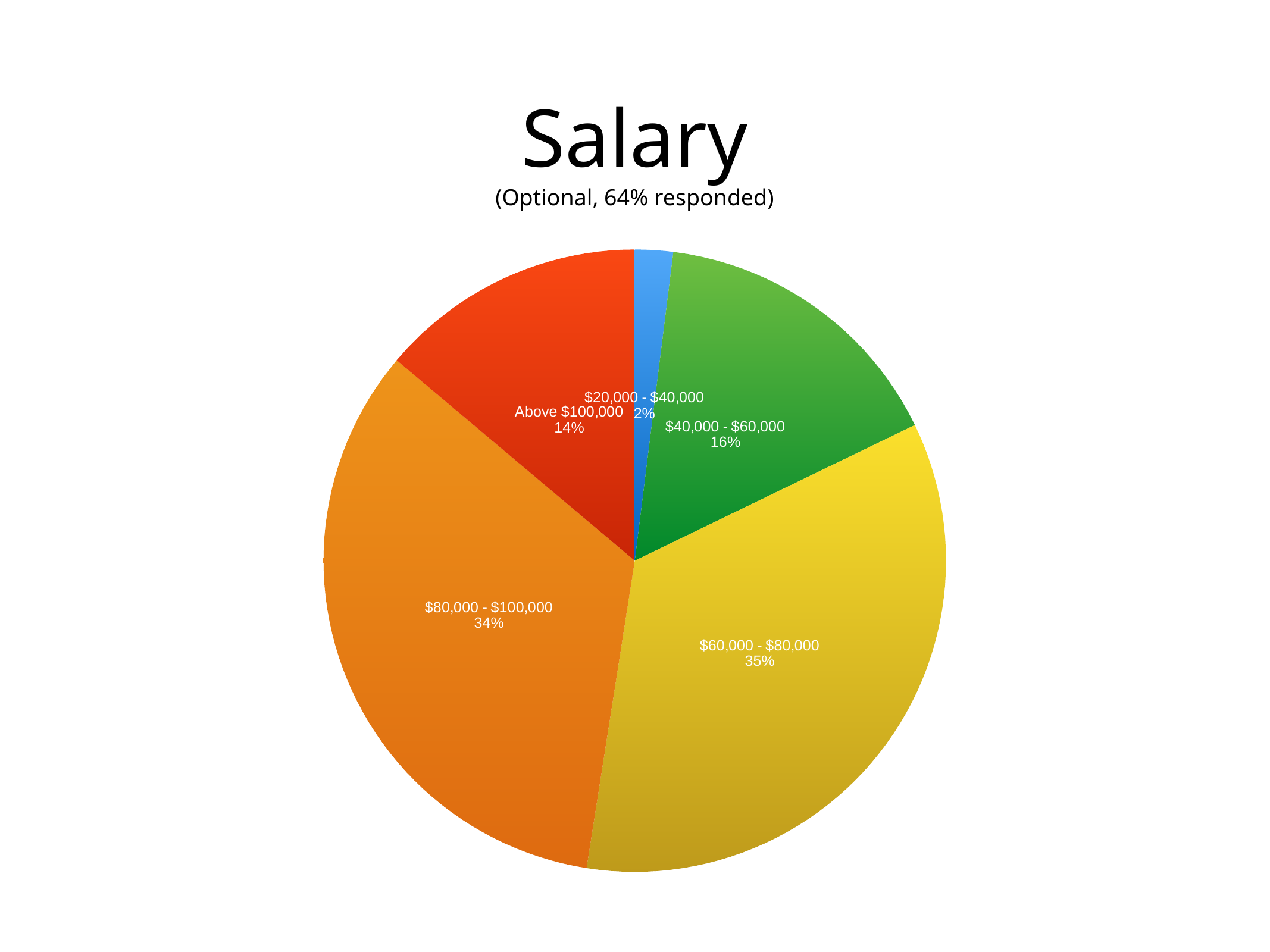
What share of the pie does the $80,000 - $100,000 slice represent? 34% According to the subtitle, what percentage of people responded to this optional question? 64% What is the title of the chart? Salary What share of the pie does the Above $100,000 slice represent? 14% What is the difference in percentage points between the $40,000 - $60,000 slice and the Above $100,000 slice? 2% What share of the pie does the $60,000 - $80,000 slice represent? 35% Which is larger, the $40,000 - $60,000 slice or the Above $100,000 slice? $40,000 - $60,000 Which salary range has the smallest slice of the pie? $20,000 - $40,000 How many slices does the pie chart have? 5 What kind of chart is shown on the slide? pie chart